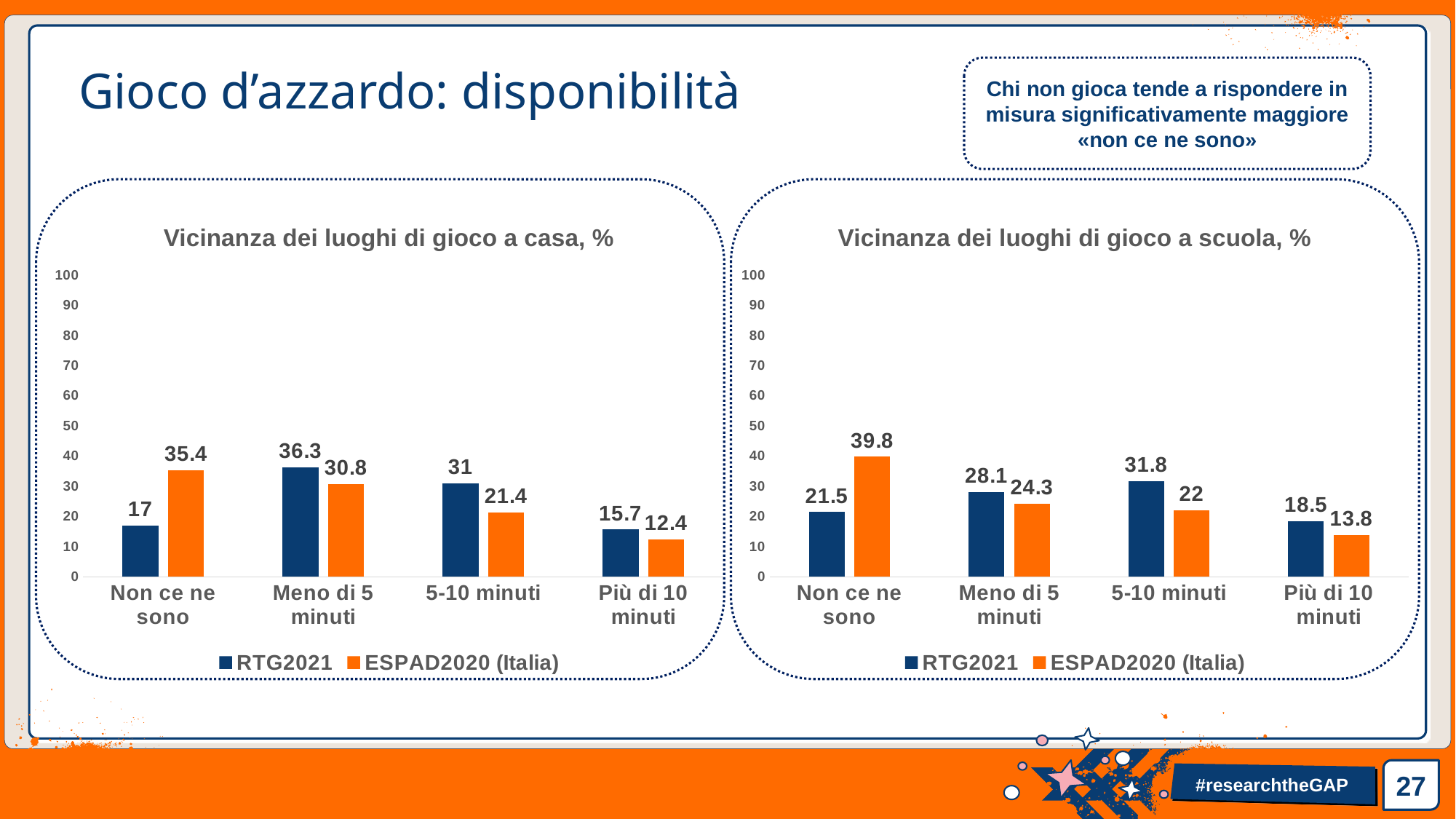
In the chart 'Vicinanza dei luoghi di gioco a scuola, %', what is the difference between the RTG2021 and ESPAD2020 (Italia) values for '5-10 minuti'? 9.8 How many categories are shown on the x axis of the chart 'Vicinanza dei luoghi di gioco a casa, %'? 4 How many series does the legend of the chart 'Vicinanza dei luoghi di gioco a scuola, %' list? 2 In the chart 'Vicinanza dei luoghi di gioco a casa, %', what is the RTG2021 value for 'Meno di 5 minuti'? 36.3 What kind of chart is 'Vicinanza dei luoghi di gioco a casa, %'? bar chart In the chart 'Vicinanza dei luoghi di gioco a scuola, %', which colour represents the ESPAD2020 (Italia) series? orange In the chart 'Vicinanza dei luoghi di gioco a scuola, %', which category has the lowest RTG2021 value? Più di 10 minuti In the chart 'Vicinanza dei luoghi di gioco a casa, %', which series has the larger value for '5-10 minuti'? RTG2021 In the chart 'Vicinanza dei luoghi di gioco a casa, %', which category has the highest ESPAD2020 (Italia) value? Non ce ne sono In the chart 'Vicinanza dei luoghi di gioco a scuola, %', is the RTG2021 value for 'Meno di 5 minuti' greater or less than 30? less In the chart 'Vicinanza dei luoghi di gioco a scuola, %', what is the ESPAD2020 (Italia) value for 'Non ce ne sono'? 39.8 In the chart 'Vicinanza dei luoghi di gioco a casa, %', what is the difference between the ESPAD2020 (Italia) and RTG2021 values for 'Non ce ne sono'? 18.4